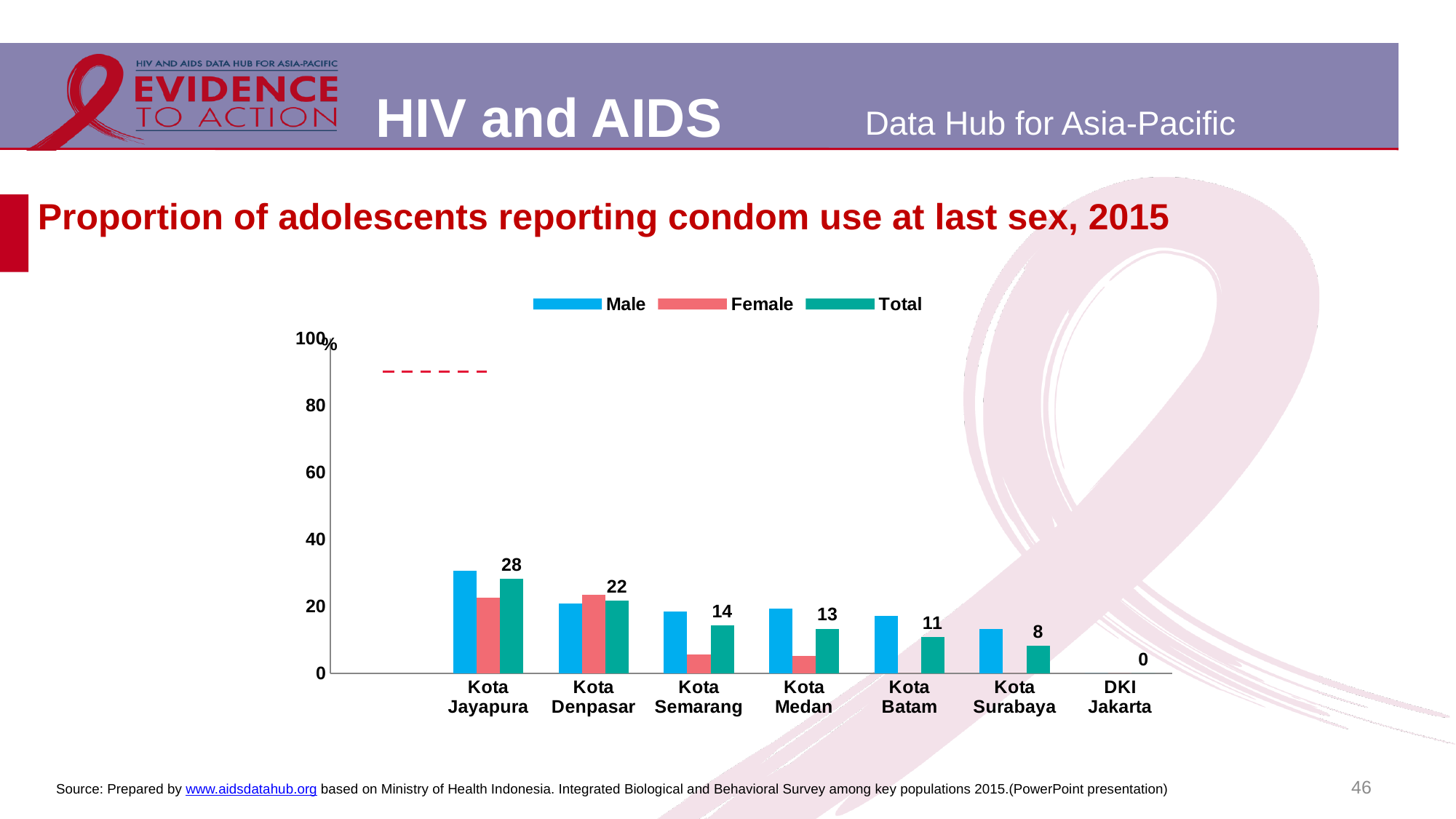
Which city has the highest Total value? Kota Jayapura How many cities are shown on the x axis? 7 Which city has the lowest Total value? DKI Jakarta What is the Total value for Kota Semarang? 14 What is the Total value for Kota Jayapura? 28 What is the difference between the Total values for Kota Jayapura and Kota Surabaya? 20 How many series does the legend list? 3 Is the Male value for Kota Jayapura greater or less than 20? greater Do the Total values rise or fall from left to right across the cities? fall What is the Total value for DKI Jakarta? 0 In Kota Semarang, which is larger, the Male bar or the Female bar? Male Which is larger, the Total value for Kota Denpasar or for Kota Medan? Kota Denpasar